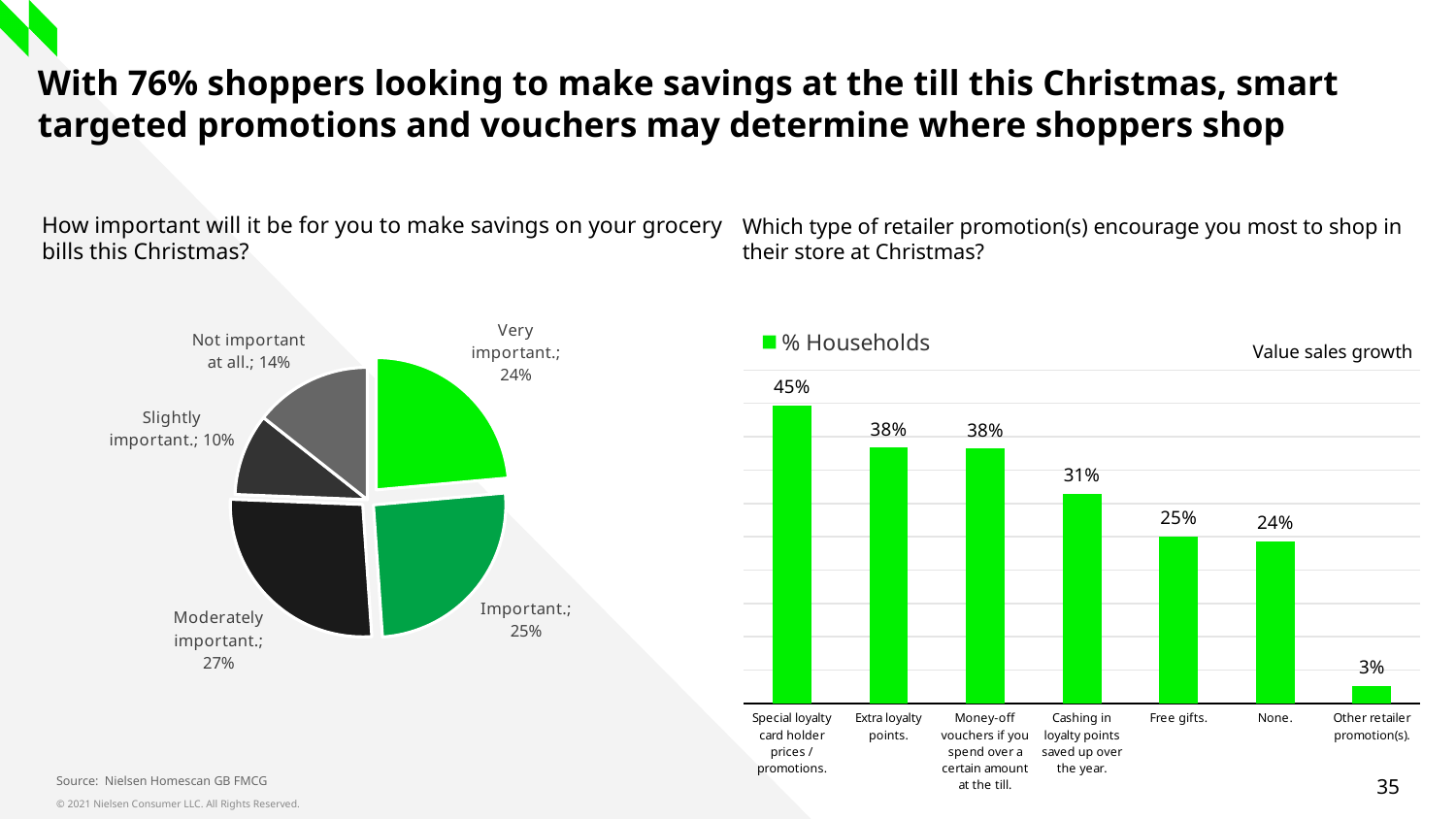
In the pie chart on the left, what share of respondents said making savings on grocery bills this Christmas is 'Moderately important'? 27% In the bar chart on the right, which retailer promotion has the lowest value? Other retailer promotion(s). In the bar chart on the right, what percentage of households are encouraged most by 'Special loyalty card holder prices / promotions'? 45% In the bar chart on the right, how many categories are shown on the x axis? 7 In the pie chart on the left, how many slices are there? 5 What type of chart is shown on the right side of the slide? Bar chart In the bar chart on the right, what series name does the legend show? % Households In the pie chart on the left, which category has the smallest slice? Slightly important. In the bar chart on the right, what is the difference between 'Cashing in loyalty points saved up over the year' and 'Free gifts'? 6% In the pie chart on the left, what is the difference between the 'Not important at all' and 'Slightly important' shares? 4% In the bar chart on the right, which is larger: 'Free gifts' or 'None'? Free gifts. In the pie chart on the left, which category has the largest slice? Moderately important.